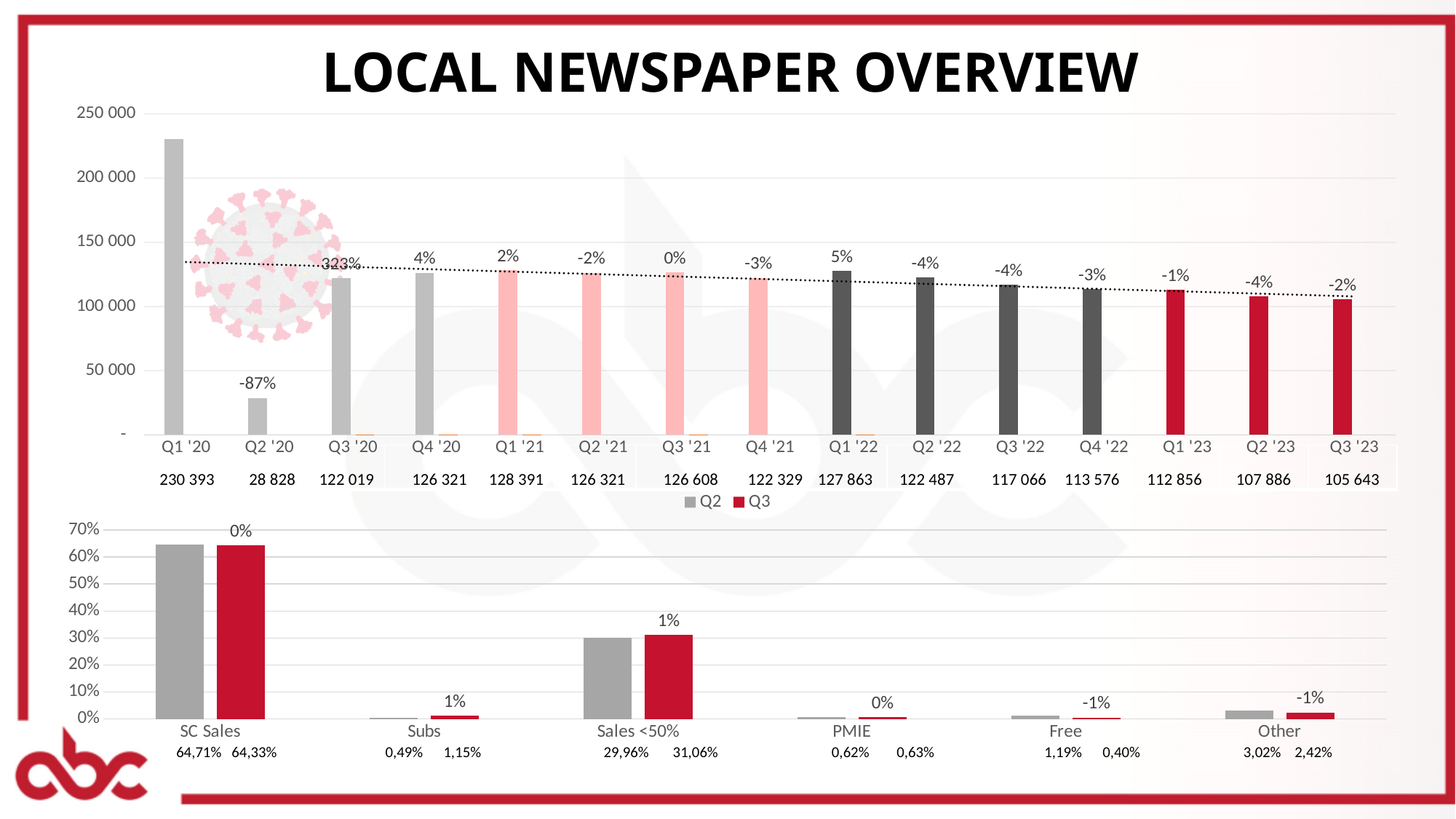
In the top chart, how many quarters are plotted? 15 What type of chart is the bottom chart? Bar chart In the bottom chart, what is the Q3 value for Sales <50%? 31,06% In the top chart, which quarter has the highest value? Q1 '20 In the bottom chart, how many series does the legend list? 2 In the top chart, what is the difference between the values for Q1 '22 and Q2 '22? 5 376 In the top chart, what is the value for Q3 '23? 105 643 In the top chart, what is the value for Q1 '20? 230 393 In the top chart, what percentage change is shown above the Q2 '20 bar? -87% In the top chart, which quarter has the lowest value? Q2 '20 In the top chart, is the value for Q4 '22 greater or less than 100 000? greater In the bottom chart, which is larger for Free: the Q2 value or the Q3 value? Q2